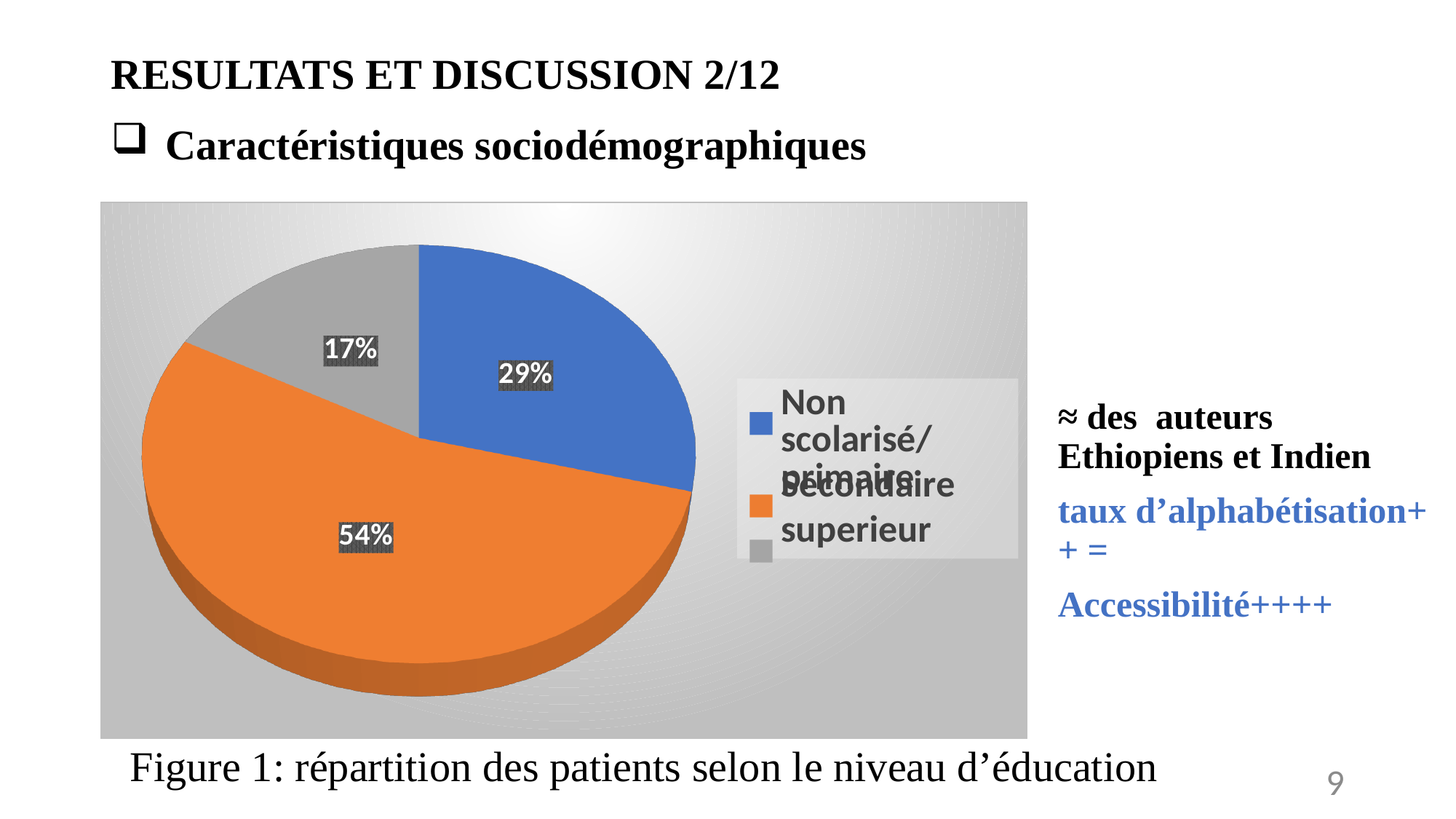
Which is larger, the Non scolarisé/primaire slice or the superieur slice? Non scolarisé/primaire What percentage of patients are in the Secondaire category? 54% Which education level has the smallest share of patients? superieur What is the difference in percentage points between the Non scolarisé/primaire and superieur slices? 12 What is the caption of the figure below the chart? Figure 1: répartition des patients selon le niveau d'éducation What is the difference in percentage points between the Secondaire and superieur slices? 37 How many slices does the pie chart have? 3 What kind of chart is shown on the slide? pie chart What percentage of patients are in the superieur category? 17% What colour is the Secondaire slice in the pie chart? orange What percentage of patients are in the Non scolarisé/primaire category? 29% Which education level has the largest share of patients? Secondaire